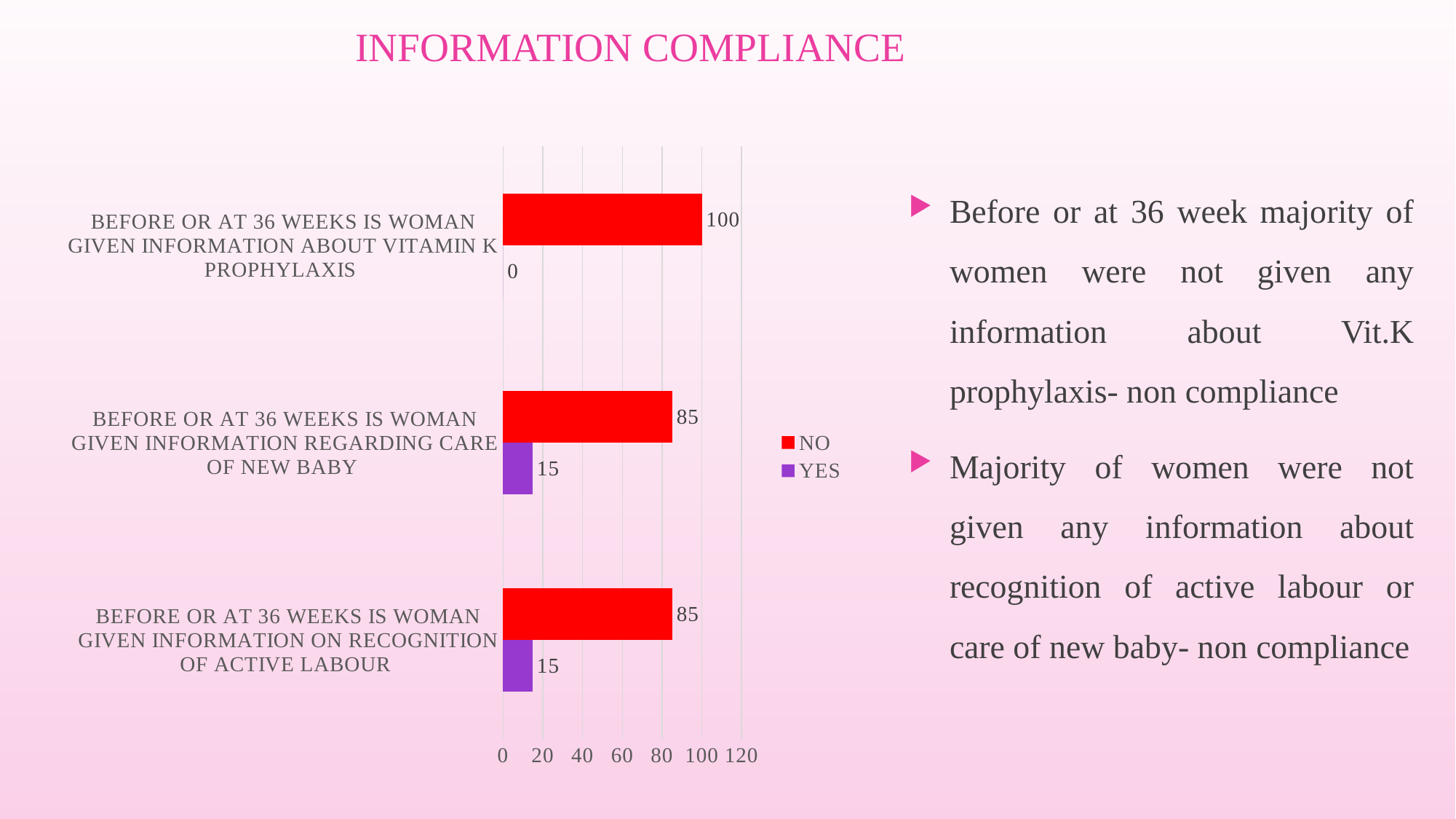
What kind of chart is shown on the slide? Bar chart For 'Before or at 36 weeks is woman given information on recognition of active labour', which is larger, NO or YES? NO What is the YES value for 'Before or at 36 weeks is woman given information regarding care of new baby'? 15 What is the NO value for 'Before or at 36 weeks is woman given information about vitamin K prophylaxis'? 100 What is the difference between the NO and YES values for 'Before or at 36 weeks is woman given information regarding care of new baby'? 70 How many categories are shown on the chart? 3 What is the YES value for 'Before or at 36 weeks is woman given information about vitamin K prophylaxis'? 0 Which colour represents the YES series in the chart? Purple What is the NO value for 'Before or at 36 weeks is woman given information on recognition of active labour'? 85 Which category has the lowest YES value? Before or at 36 weeks is woman given information about vitamin K prophylaxis How many series does the legend list? 2 Which category has the highest NO value? Before or at 36 weeks is woman given information about vitamin K prophylaxis